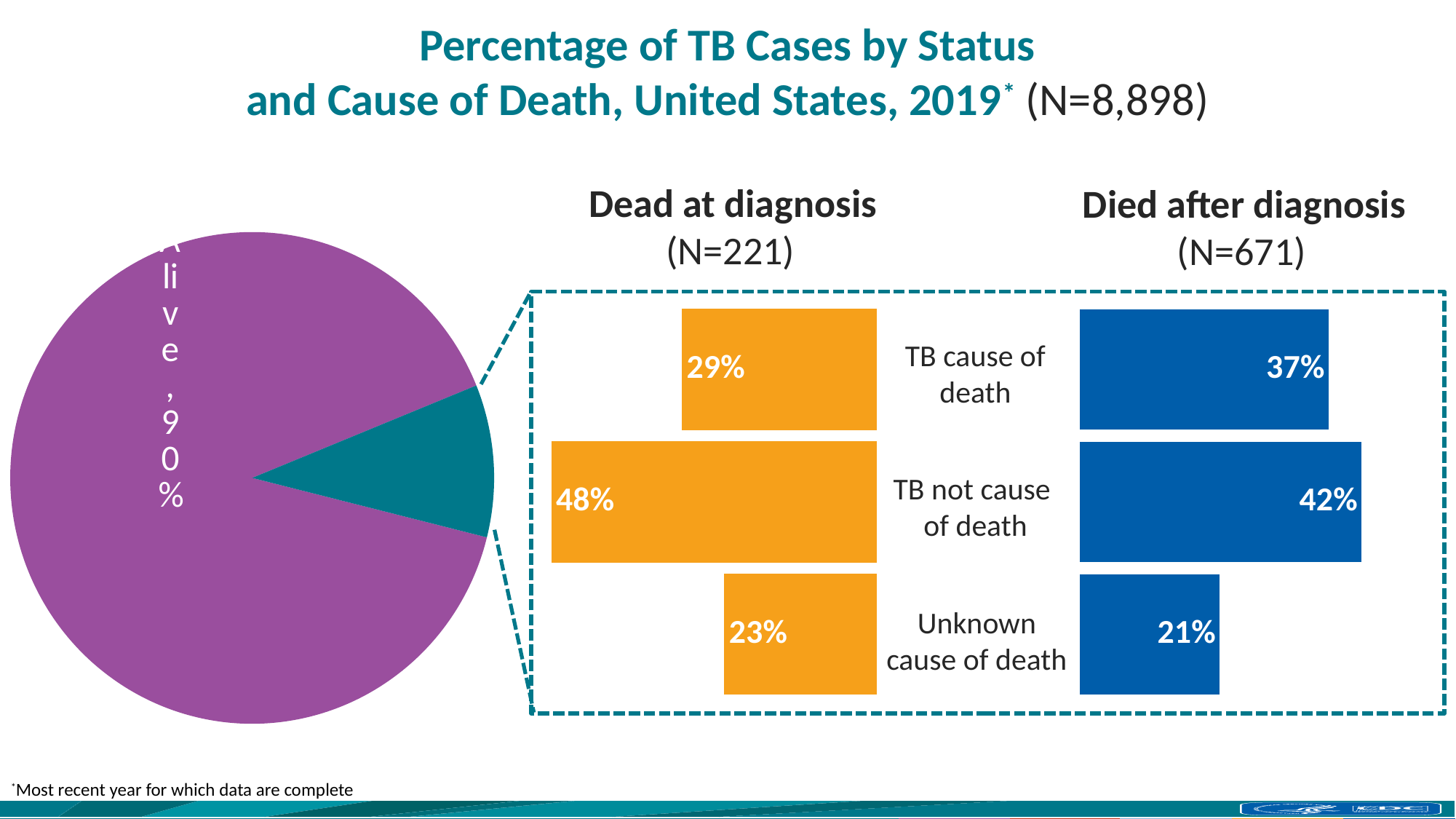
In the bar chart, what percentage of the Dead at diagnosis group had TB as the cause of death? 29% What is the N for the Died after diagnosis group shown above the bar chart? 671 In the bar chart, which cause-of-death category has the lowest percentage for the Died after diagnosis group? Unknown cause of death In the bar chart, which group has the larger percentage for TB not cause of death, Dead at diagnosis or Died after diagnosis? Dead at diagnosis What kind of chart is on the left side of the slide? Pie chart In the bar chart, what percentage of the Died after diagnosis group had an unknown cause of death? 21% In the bar chart, what percentage of the Died after diagnosis group had TB not as the cause of death? 42% In the pie chart, what percentage of TB cases were alive? 90% In the bar chart, what is the difference between the Dead at diagnosis and Died after diagnosis percentages for TB cause of death? 8% In the bar chart, which group has the larger percentage for Unknown cause of death, Dead at diagnosis or Died after diagnosis? Dead at diagnosis How many cause-of-death categories are shown in the bar chart? 3 In the bar chart, which cause-of-death category has the highest percentage for the Dead at diagnosis group? TB not cause of death